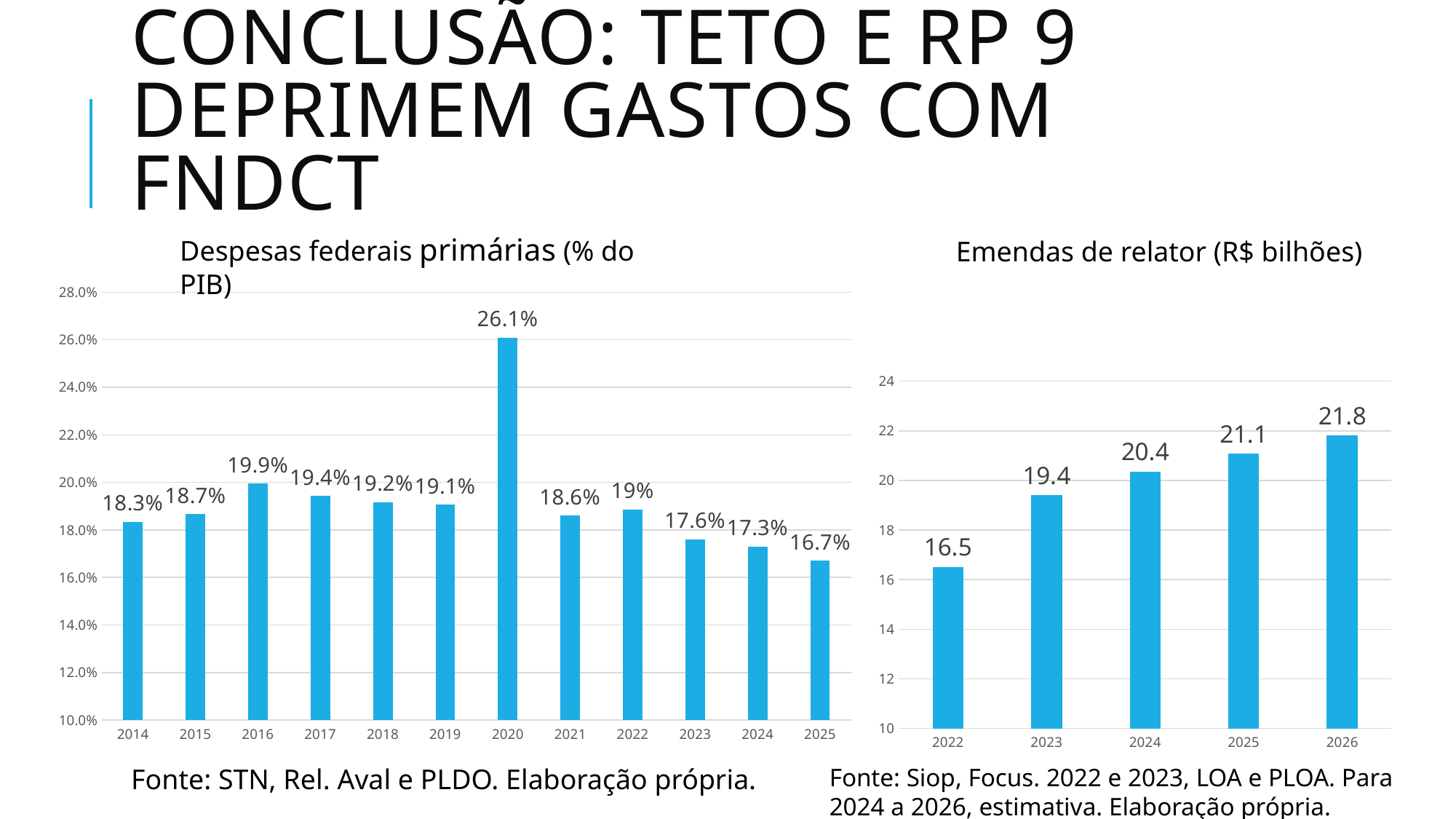
In the 'Emendas de relator (R$ bilhões)' chart, what is the value for 2024? 20.4 In the 'Emendas de relator (R$ bilhões)' chart, what is the difference between the 2026 value and the 2022 value? 5.3 In the 'Despesas federais primárias (% do PIB)' chart, which year has the highest value? 2020 In the 'Despesas federais primárias (% do PIB)' chart, how many years are shown on the x axis? 12 In the 'Despesas federais primárias (% do PIB)' chart, what is the difference between the 2020 value and the 2021 value? 7.5 percentage points In the 'Despesas federais primárias (% do PIB)' chart, is the value for 2016 larger or smaller than the value for 2017? larger In the 'Emendas de relator (R$ bilhões)' chart, which year has the lowest value? 2022 In the 'Despesas federais primárias (% do PIB)' chart, which year has the lowest value? 2025 In the 'Emendas de relator (R$ bilhões)' chart, do the values rise or fall from 2022 to 2026? rise What type of chart is the 'Emendas de relator (R$ bilhões)' chart? bar chart In the 'Emendas de relator (R$ bilhões)' chart, how many bars are there? 5 In the 'Despesas federais primárias (% do PIB)' chart, what is the value for 2020? 26.1%